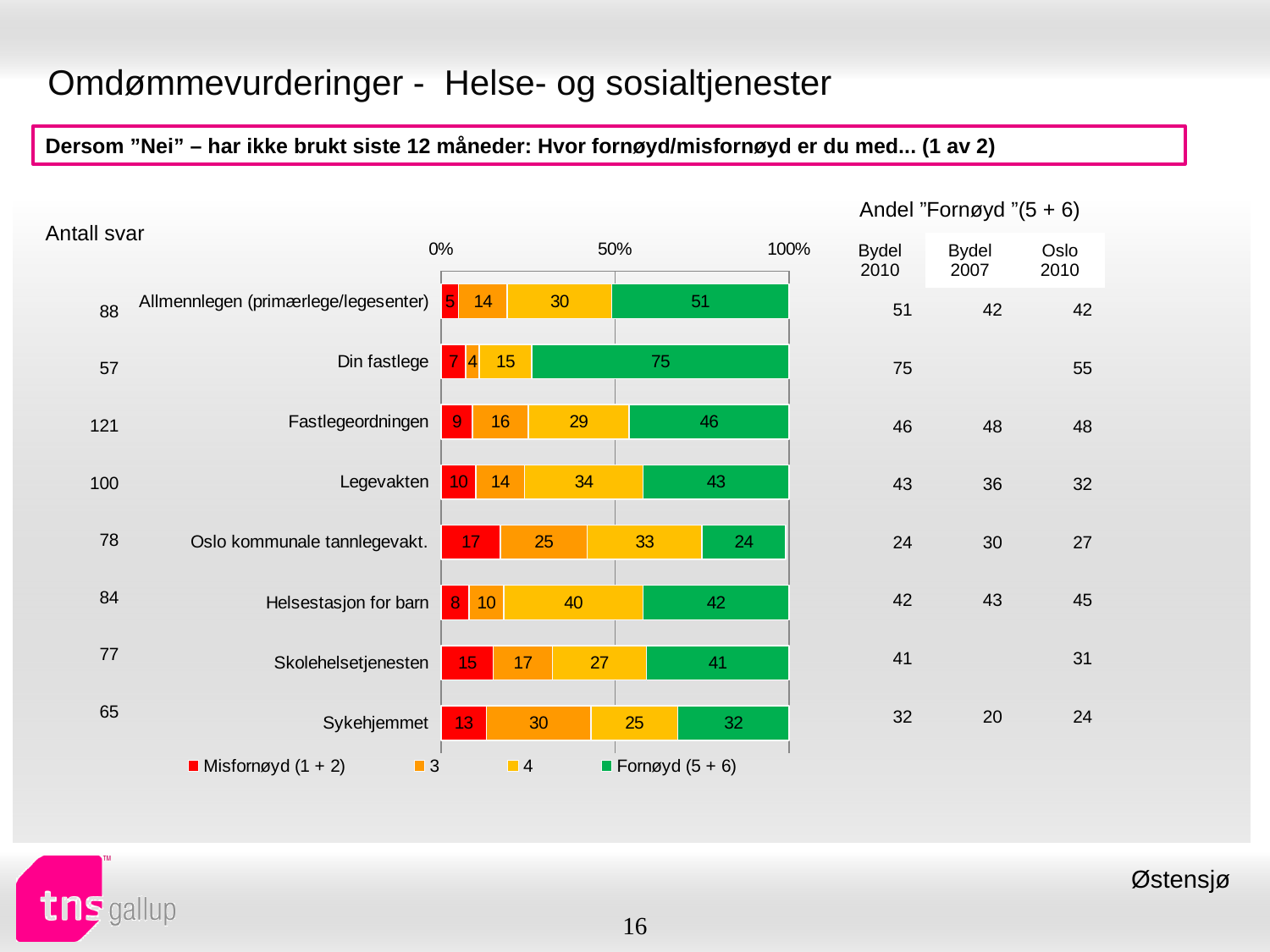
What is the value of the Misfornøyd (1 + 2) segment for Oslo kommunale tannlegevakt.? 17 What is the total of the stacked bar for Sykehjemmet? 100 How many series does the legend list? 4 Which has the larger Misfornøyd (1 + 2) value, Skolehelsetjenesten or Sykehjemmet? Skolehelsetjenesten What is the difference between the Fornøyd (5 + 6) values for Allmennlegen (primærlege/legesenter) and Legevakten? 8 What is the value of the '4' segment for Helsestasjon for barn? 40 Which category has the lowest Fornøyd (5 + 6) value? Oslo kommunale tannlegevakt. What colour represents Fornøyd (5 + 6) in the legend? Green How many categories are shown in the bar chart? 8 Which category has the highest Fornøyd (5 + 6) value? Din fastlege What kind of chart is shown on the slide? Stacked bar chart What is the value of the Fornøyd (5 + 6) segment for Din fastlege? 75